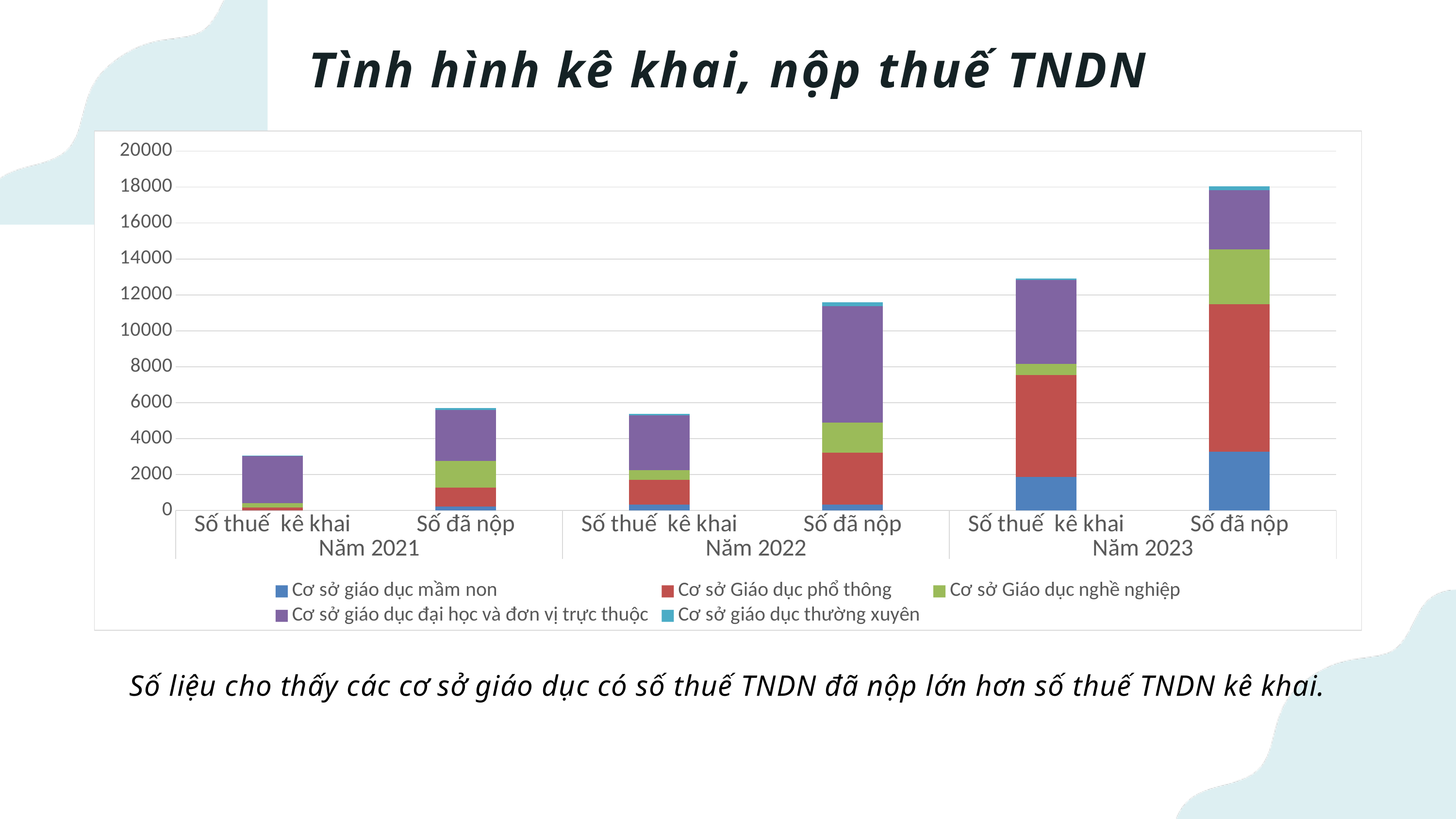
Which bar has the lowest total value? Số thuế kê khai, Năm 2021 Which bar has the highest total value? Số đã nộp, Năm 2023 How many bars are plotted in the chart? 6 Is the total for Số đã nộp in Năm 2021 greater or less than 8000? less Do the totals for Số đã nộp rise or fall from Năm 2021 to Năm 2023? rise What is the title of the slide containing the chart? Tình hình kê khai, nộp thuế TNDN Is the total for Số đã nộp in Năm 2023 greater or less than 16000? greater In Năm 2022, which is larger: the total for Số thuế kê khai or Số đã nộp? Số đã nộp How many series does the legend list? 5 Is the total for Số thuế kê khai in Năm 2021 greater or less than 4000? less What kind of chart is shown on the slide? stacked bar chart